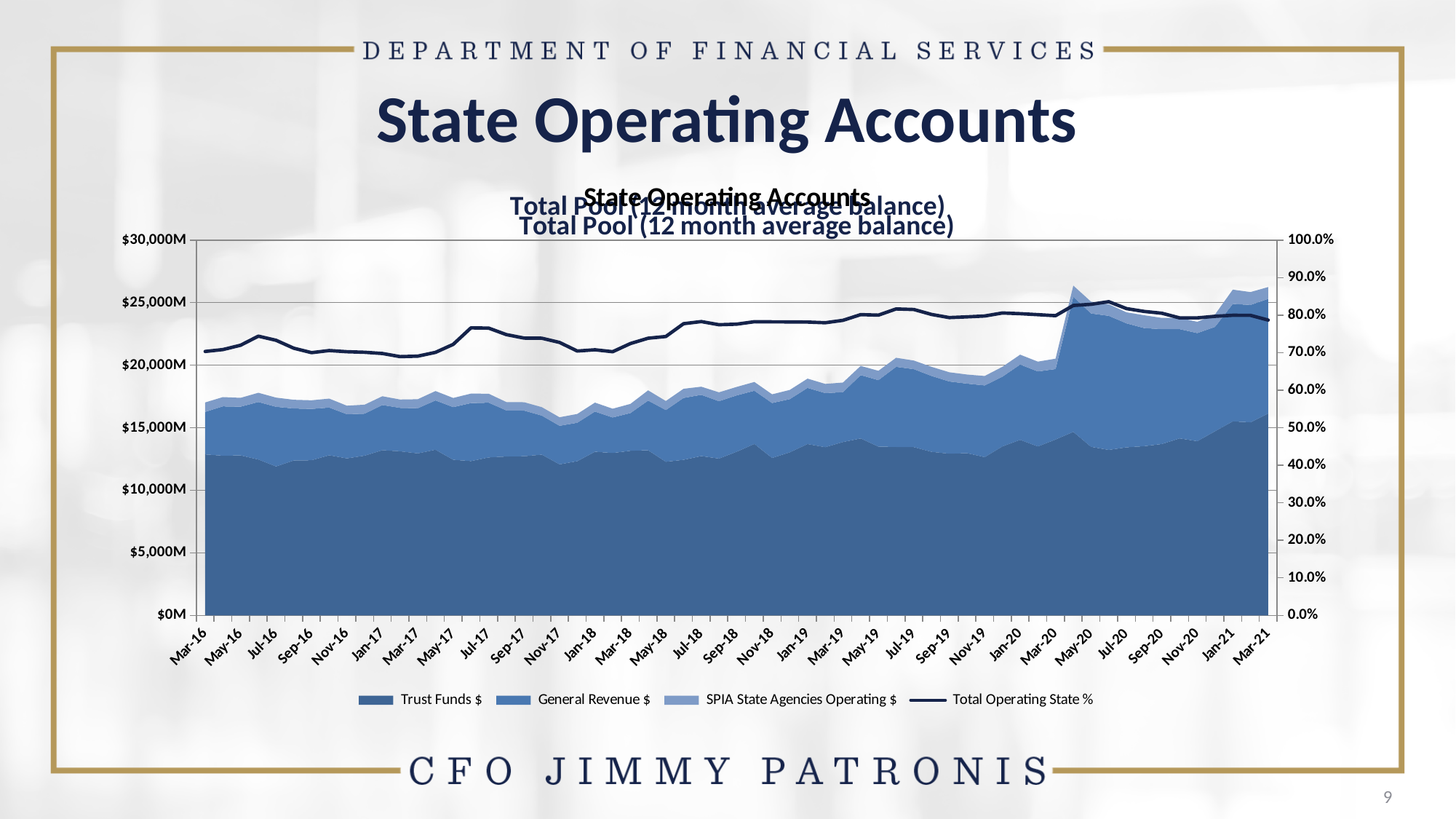
Is the Trust Funds $ value at Mar-16 greater or less than $10,000M? greater Which is larger, the Total Operating State % at Jul-20 or at Mar-16? Jul-20 What kind of chart is shown on the slide? combination area and line chart Which series is plotted as a line rather than a filled area? Total Operating State % Is the Total Operating State % at Jul-20 greater or less than 80.0%? greater Is the Total Operating State % at Mar-16 greater or less than 60.0%? greater Which of the three stacked series has the largest balance throughout the period? Trust Funds $ How many series does the legend list? 4 Does the Total Operating State % line generally rise or fall from Mar-16 to Mar-21? rise What is the highest value shown on the left vertical axis? $30,000M